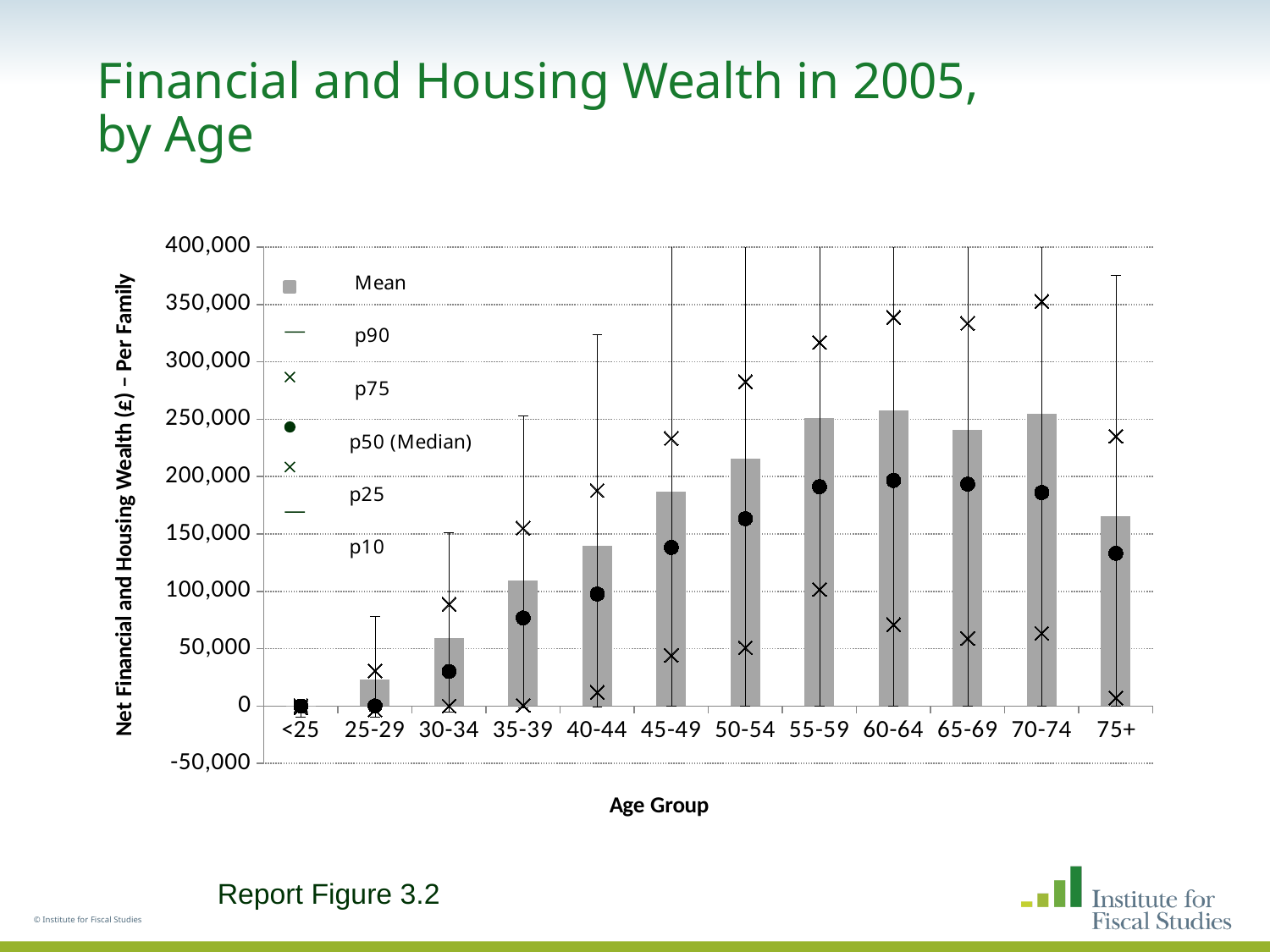
How many series does the legend list? 6 Which age group has the lowest Mean net financial and housing wealth? <25 Is the p75 value for the 70-74 age group greater or less than 300,000? greater How many age groups are shown on the x axis? 12 Is the Mean value for the 30-34 age group greater or less than 100,000? less What is the title of the chart? Financial and Housing Wealth in 2005, by Age Is the Mean value for the 55-59 age group greater or less than 200,000? greater Does the Mean value rise or fall from the <25 age group to the 60-64 age group? rise What is the label of the y axis? Net Financial and Housing Wealth (£) – Per Family Which age group has the larger Mean value, 35-39 or 50-54? 50-54 What kind of chart is used to show the Mean values? bar chart